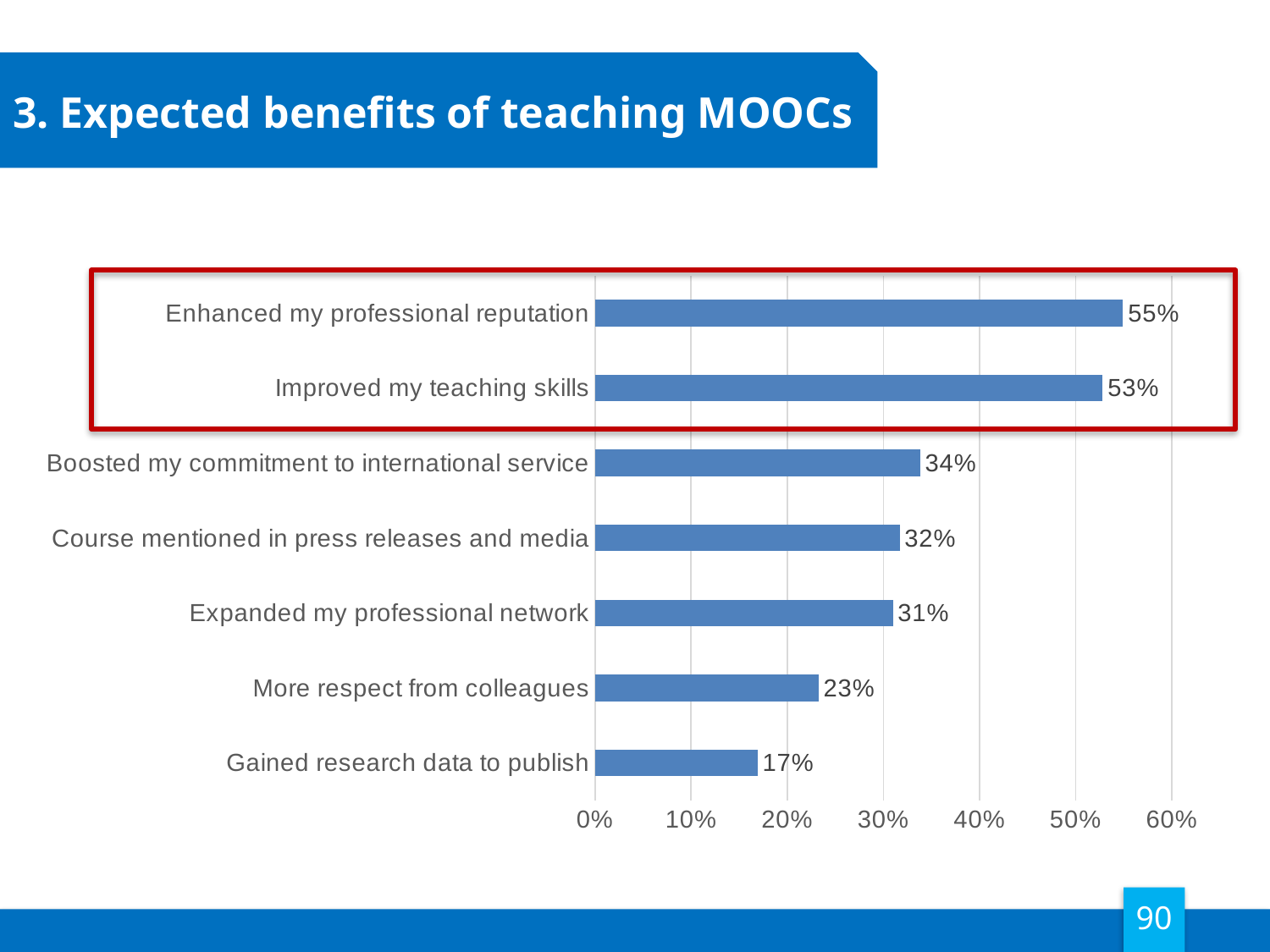
What percentage of respondents expected that teaching MOOCs would enhance their professional reputation? 55% What is the value shown for 'Course mentioned in press releases and media'? 32% Which is larger: the value for 'Expanded my professional network' or the value for 'More respect from colleagues'? Expanded my professional network What kind of chart is shown on the slide? Bar chart What is the value shown for 'Gained research data to publish'? 17% Which expected benefit has the lowest percentage? Gained research data to publish Is the value for 'Improved my teaching skills' greater or less than 50%? greater What is the difference in percentage points between 'Enhanced my professional reputation' and 'Improved my teaching skills'? 2 percentage points Which expected benefit has the highest percentage? Enhanced my professional reputation What is the difference in percentage points between 'Boosted my commitment to international service' and 'More respect from colleagues'? 11 percentage points Which two categories are enclosed by the red box on the chart? Enhanced my professional reputation and Improved my teaching skills How many expected benefits are listed in the chart? 7